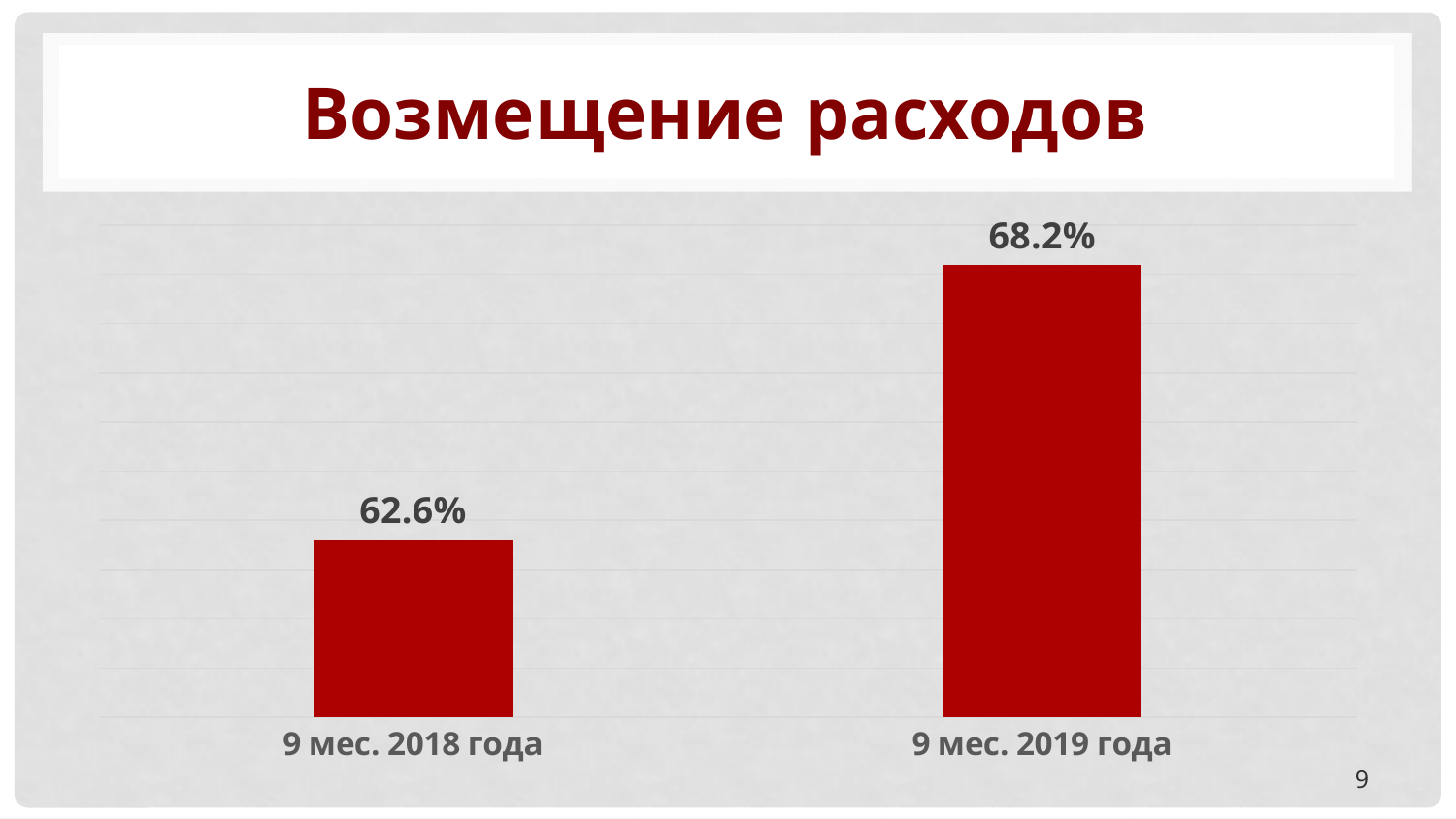
Which is larger, the value for 9 мес. 2018 года or 9 мес. 2019 года? 9 мес. 2019 года What is the value for 9 мес. 2018 года? 62.6% Which category has the lowest value? 9 мес. 2018 года Do the values rise or fall from 9 мес. 2018 года to 9 мес. 2019 года? rise What is the value for 9 мес. 2019 года? 68.2% Which category has the highest value? 9 мес. 2019 года What colour are the bars in the chart? dark red What kind of chart is shown on the slide? bar chart What is the difference between the values for 9 мес. 2019 года and 9 мес. 2018 года? 5.6% What is the title of the slide? Возмещение расходов How many categories are shown in the chart? 2